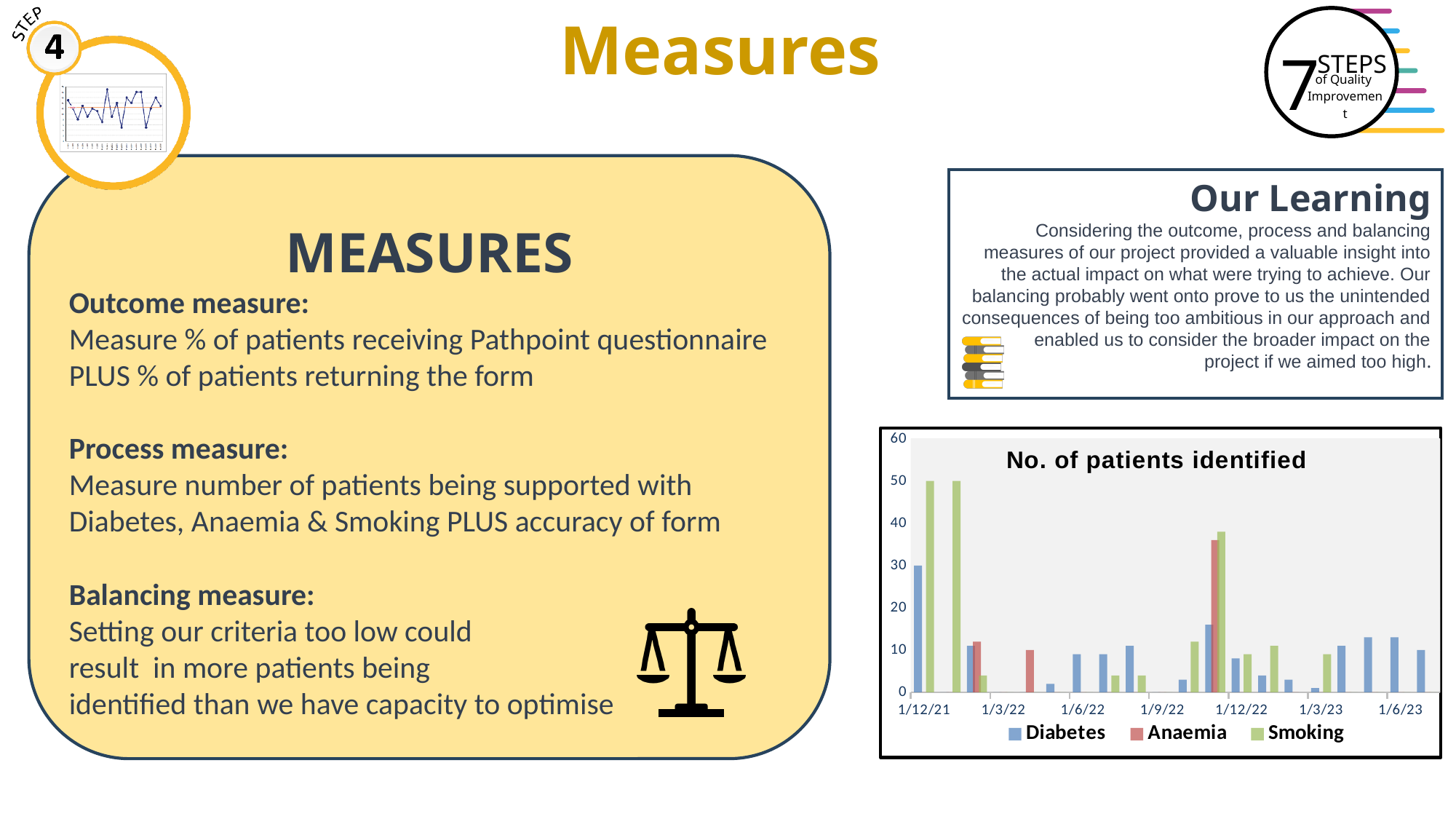
Is the value for Diabetes at 1/12/21 greater or less than 20? greater Which series has the tallest bar in the chart? Smoking Is the value for Smoking at 1/12/21 greater or less than 40? greater What kind of chart is shown on the slide? bar chart How many series does the chart's legend list? 3 At 1/12/21, which is larger: the Diabetes bar or the Smoking bar? Smoking What is the highest value shown on the chart's y axis? 60 Is the value for Diabetes at 1/6/23 greater or less than 20? less Which series are listed in the chart's legend? Diabetes, Anaemia, Smoking What is the title of the chart on the slide? No. of patients identified How many date labels are shown on the x axis of the chart? 7